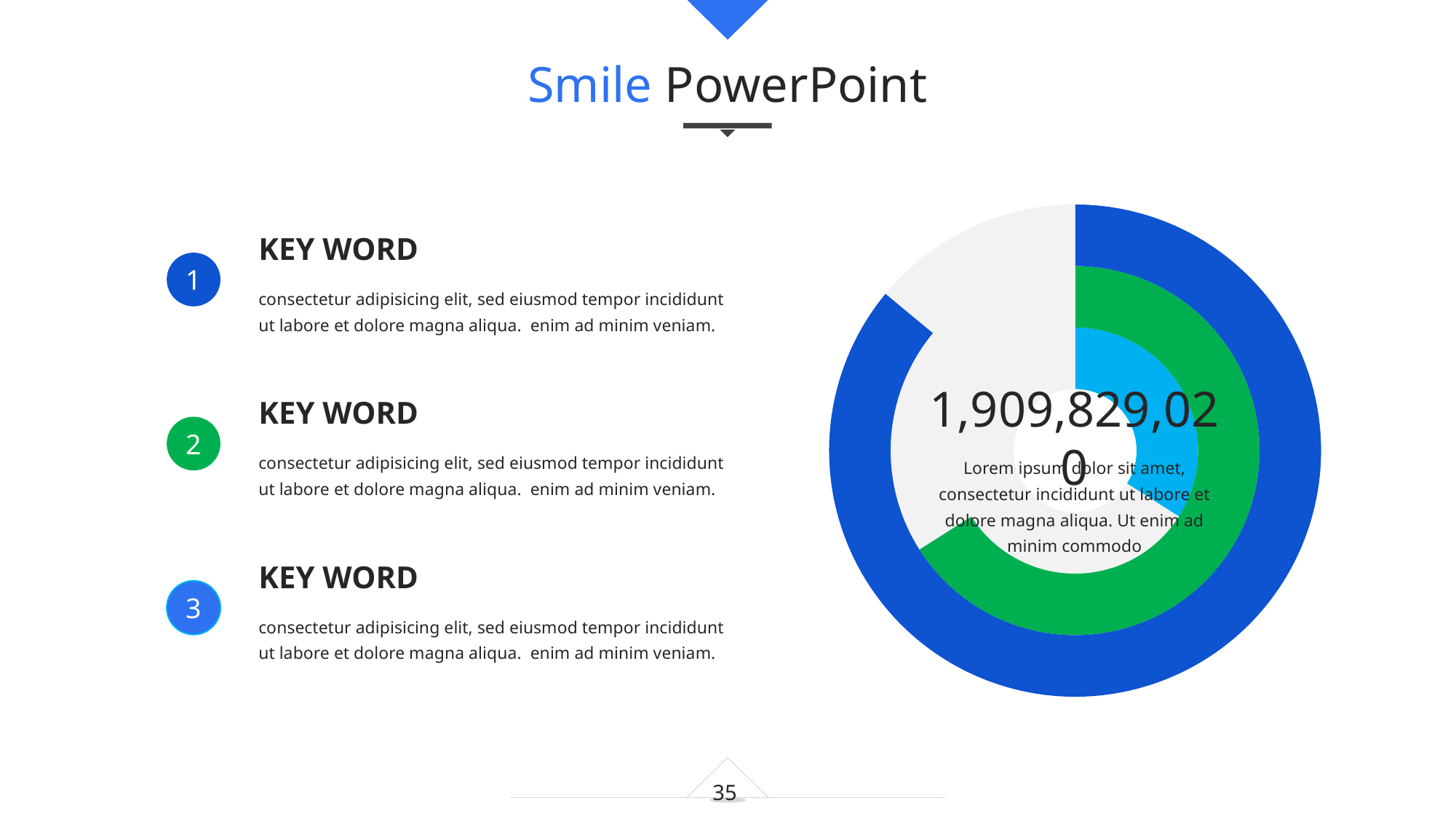
What colour is the outermost ring of the donut chart? blue Is the filled portion of the outer blue ring larger or smaller than the filled portion of the inner light blue ring? larger How many rings (series) does the donut chart on the right contain? 3 Which ring of the donut chart is filled the most: the outer blue ring, the middle green ring, or the inner light blue ring? the outer blue ring Is the filled portion of the middle green ring larger or smaller than the filled portion of the inner light blue ring? larger What number is printed in the centre of the donut chart? 1,909,829,020 What kind of chart is shown on the right of the slide? donut chart Which ring of the donut chart is filled the least: the outer blue ring, the middle green ring, or the inner light blue ring? the inner light blue ring